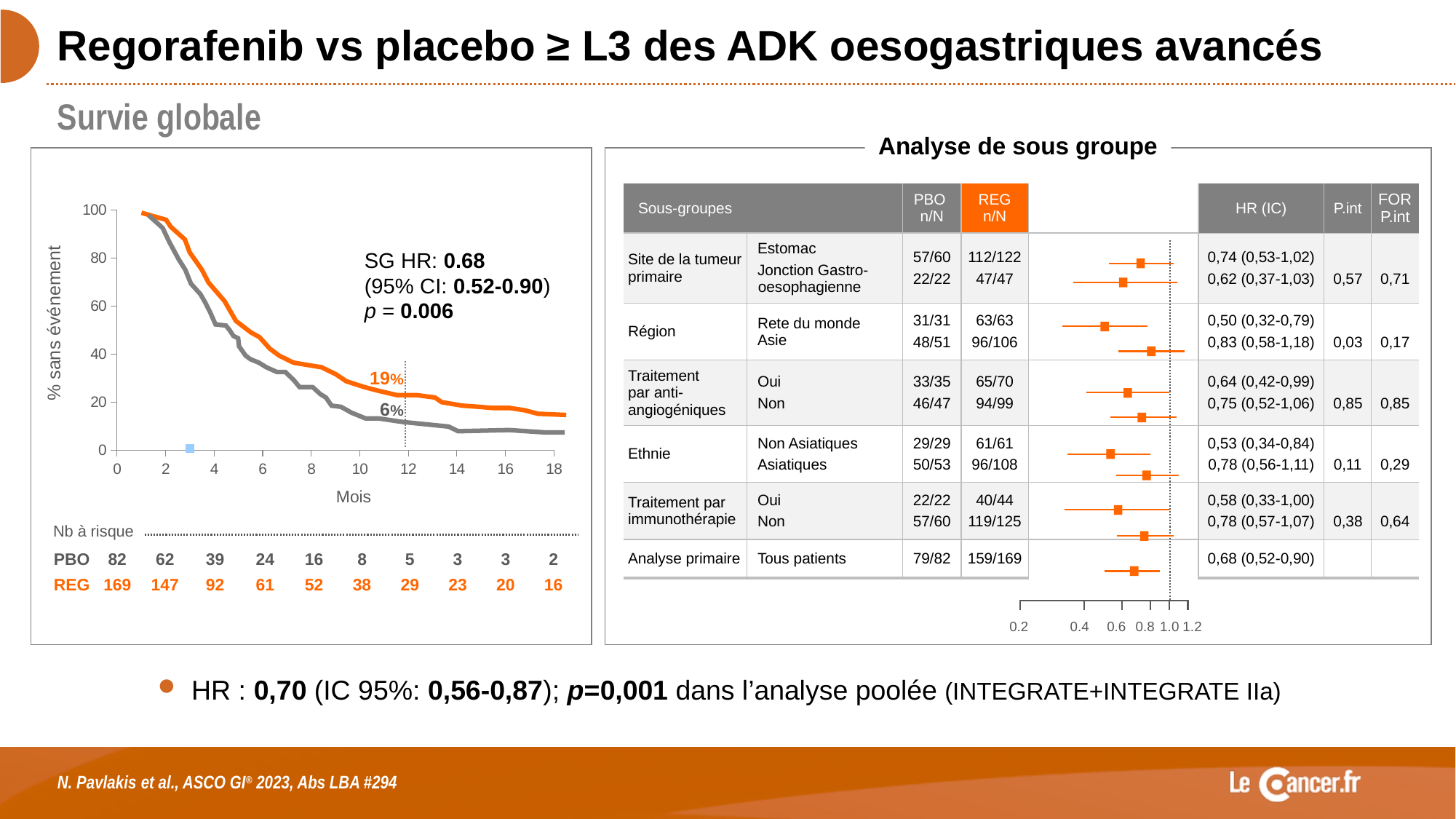
On the 'Survie globale' chart, how many REG patients are at risk at 0 months? 169 What kind of chart is the 'Survie globale' chart on the left of the slide? line chart On the 'Survie globale' chart, is the REG curve at 2 months greater or less than 80? greater On the 'Survie globale' chart, what is the difference in percentage points between the REG and PBO values at 12 months? 13 On the 'Survie globale' chart, what is the hazard ratio (SG HR) shown? 0.68 On the 'Survie globale' chart, what is the percentage without event for the REG group at 12 months? 19% On the 'Survie globale' chart, what is the percentage without event for the PBO group at 12 months? 6% On the 'Survie globale' chart, do the curves rise or fall as months increase? fall On the 'Analyse de sous groupe' forest plot, which subgroup has the lowest HR? Rete du monde On the 'Survie globale' chart, which group has the higher curve at 12 months, REG or PBO? REG On the 'Analyse de sous groupe' forest plot, what is the HR (IC) for 'Analyse primaire' (Tous patients)? 0,68 (0,52-0,90) On the 'Analyse de sous groupe' forest plot, what is the HR (IC) for the Asie subgroup? 0,83 (0,58-1,18)